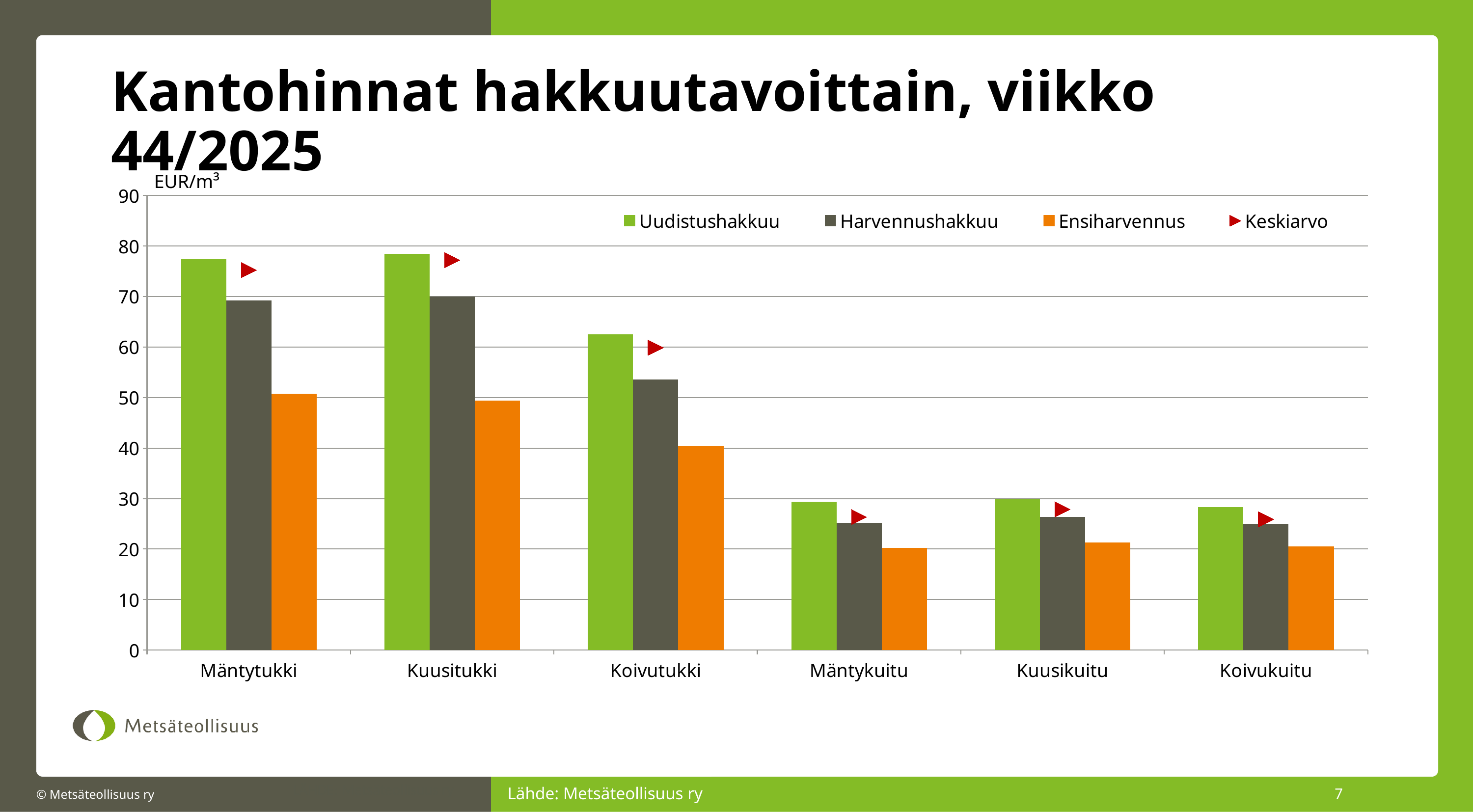
How many categories are shown on the x axis? 6 Is the Uudistushakkuu value for Mäntytukki greater or less than 70? greater Is the Ensiharvennus value for Koivutukki greater or less than 50? less How many series does the legend list? 4 Is the Ensiharvennus value for Mäntykuitu greater or less than 30? less Which is larger, the Harvennushakkuu value for Kuusitukki or for Koivutukki? Kuusitukki What unit is shown on the y axis of the chart? EUR/m³ What kind of chart is shown on the slide? bar chart Which category has the highest Uudistushakkuu value? Kuusitukki Do the Uudistushakkuu values generally rise or fall from Mäntytukki to Koivukuitu along the x axis? fall